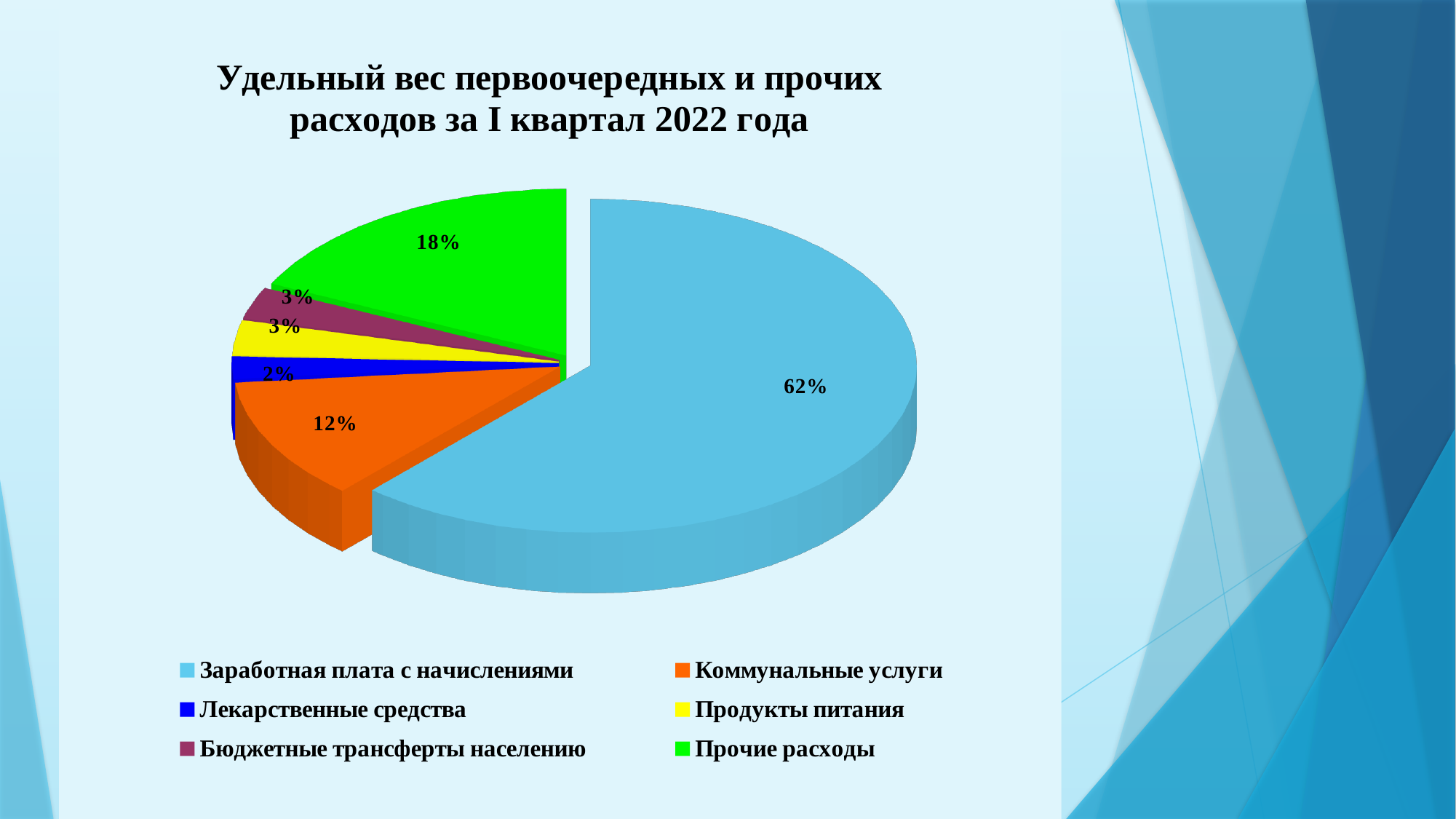
What is the difference between the shares of Прочие расходы and Коммунальные услуги? 6% What is the value shown for Лекарственные средства? 2% Which category has the largest share of the pie? Заработная плата с начислениями What is the value shown for Коммунальные услуги? 12% What share of the pie does Заработная плата с начислениями have? 62% What is the value shown for Продукты питания? 3% How many categories does the legend list? 6 Which is larger, the share of Коммунальные услуги or the share of Прочие расходы? Прочие расходы What is the value shown for Прочие расходы? 18% Which category has the smallest share of the pie? Лекарственные средства What colour is the slice for Бюджетные трансферты населению? Purple What kind of chart is shown on the slide? Pie chart